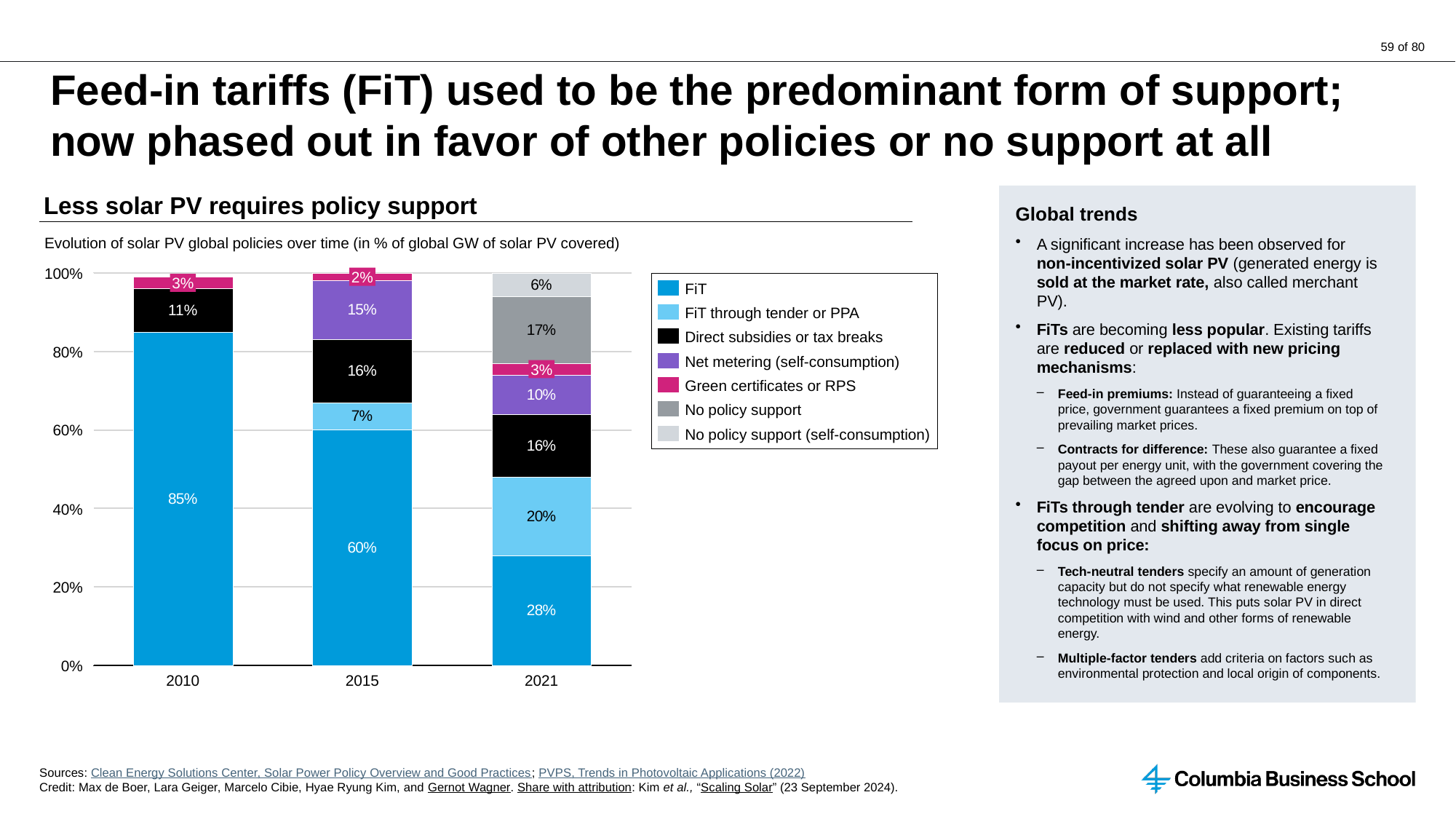
What is the value for FiT through tender or PPA in 2021? 20% In which year is the FiT share the highest? 2010 What is the value for No policy support in 2021? 17% What is the value for Net metering (self-consumption) in 2015? 15% What kind of chart is shown on the slide? Stacked bar chart Does the FiT share rise or fall from 2010 to 2021? Fall What is the difference between the FiT share in 2010 and in 2021? 57% Which is larger in 2021: Direct subsidies or tax breaks, or Net metering (self-consumption)? Direct subsidies or tax breaks In which year is the FiT share the lowest? 2021 How many years are shown on the x axis? 3 What is the FiT share in 2010? 85% How many series does the legend list? 7